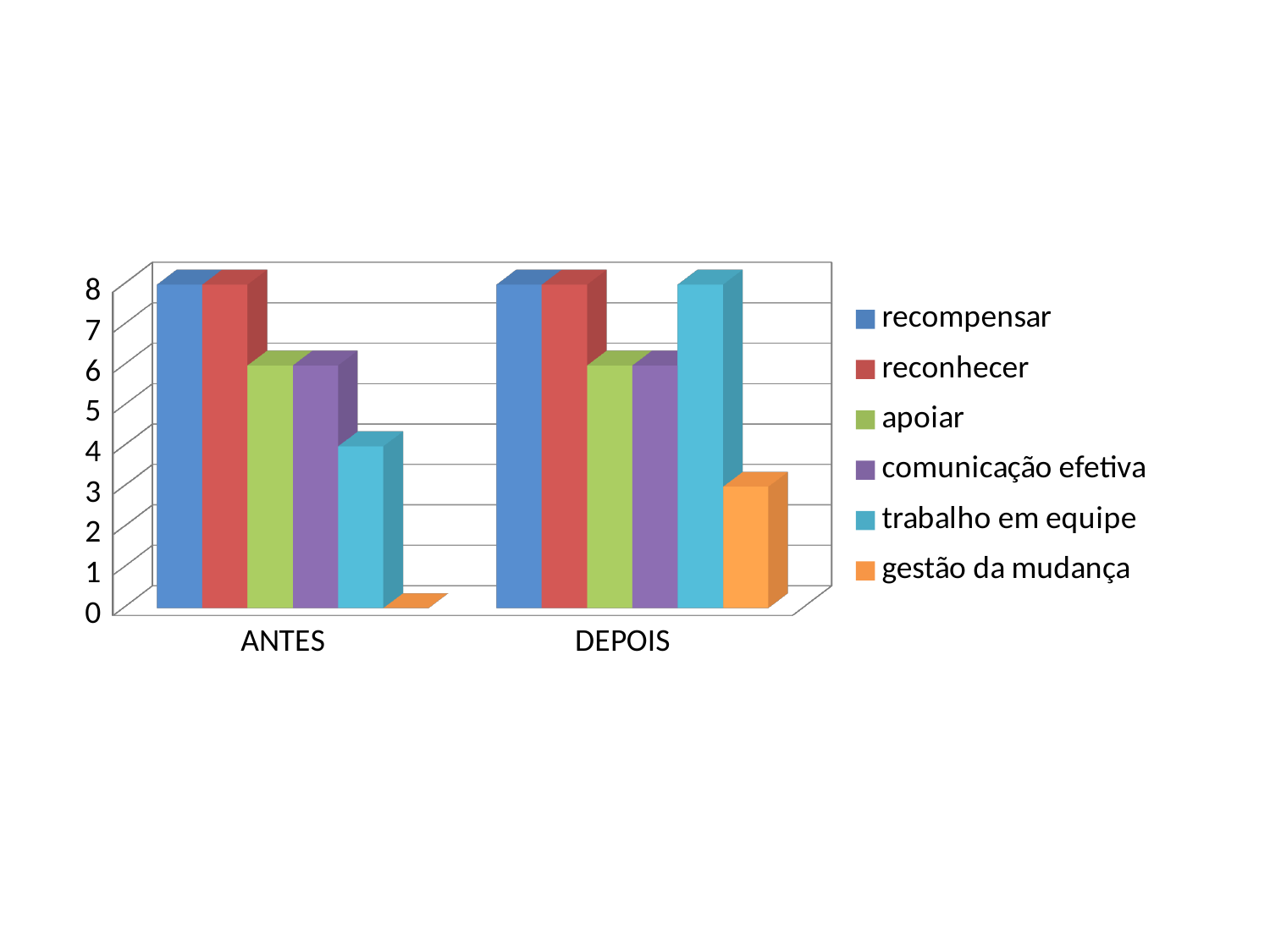
Which series has the lowest value in the DEPOIS category? gestão da mudança How many series does the legend list? 6 What is the value for gestão da mudança in ANTES? 0 What kind of chart is shown on the slide? bar chart What are the two categories on the x axis? ANTES and DEPOIS How many categories are shown on the x axis? 2 Does the value for trabalho em equipe rise or fall from ANTES to DEPOIS? rise Is the value for gestão da mudança in DEPOIS greater or less than 5? less Which is larger: trabalho em equipe in ANTES or trabalho em equipe in DEPOIS? trabalho em equipe in DEPOIS What is the value for trabalho em equipe in ANTES? 4 What is the value for trabalho em equipe in DEPOIS? 8 Which series is shown in orange in the legend? gestão da mudança